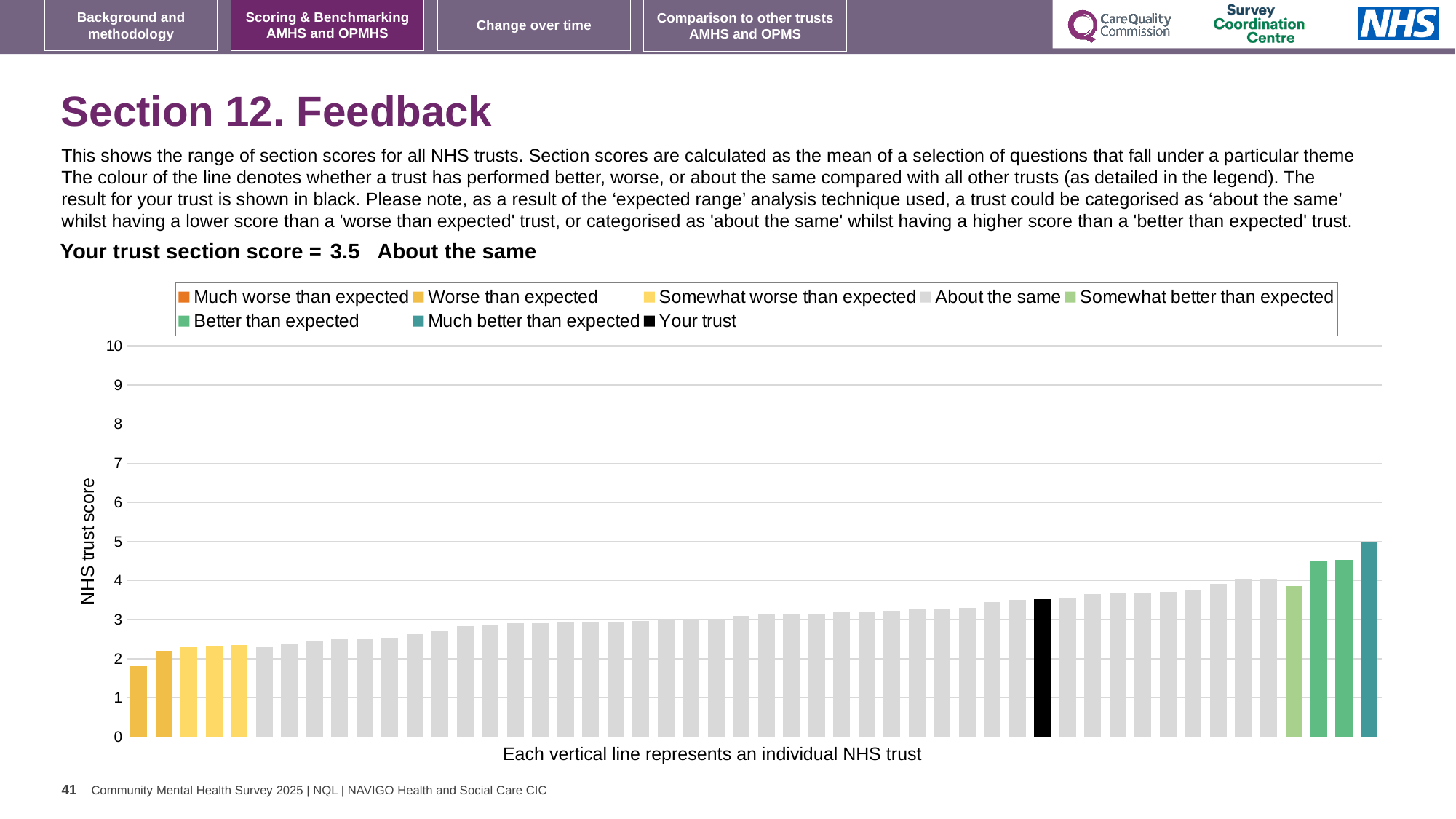
What is the section score for your trust shown on the slide? 3.5 Do the bar values rise or fall moving from left to right along the x axis? rise Is the value of the tallest bar (the rightmost, 'Much better than expected' bar) greater or less than 4? greater Is the value of the black 'Your trust' bar greater or less than 4? less How many entries does the chart legend list? 8 What kind of chart is shown on the slide? bar chart How many bars are coloured in the 'Somewhat worse than expected' yellow shade? 3 What colour is the bar representing your trust? black Is the value of the black 'Your trust' bar greater or less than 3? greater What is the label on the vertical axis of the chart? NHS trust score Which performance category is your trust placed in for this section? About the same